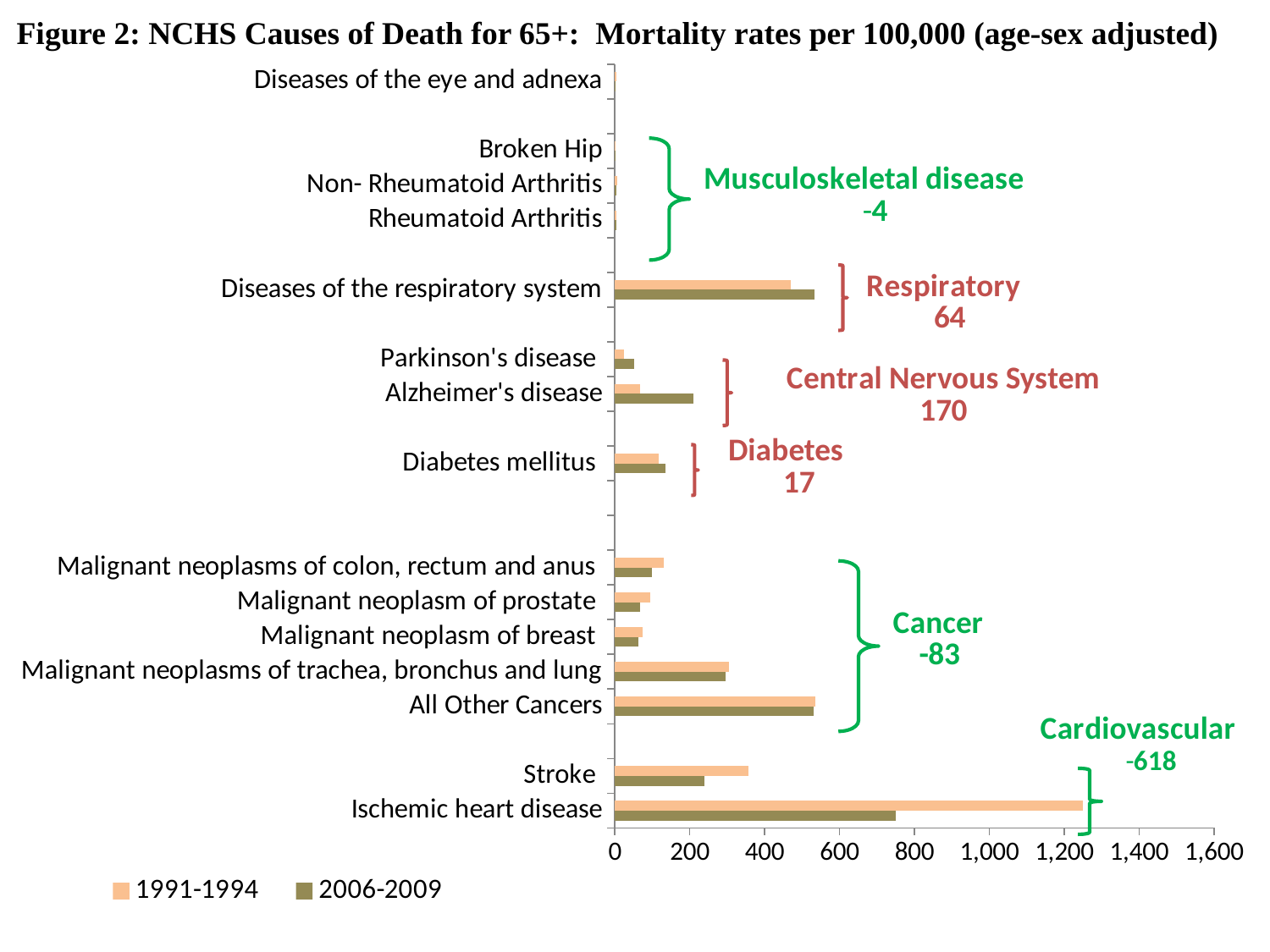
Is the 2006-2009 value for Ischemic heart disease greater or less than 800? less Which cause of death has the highest mortality rate for 2006-2009? Ischemic heart disease Is the 2006-2009 value for Diseases of the respiratory system greater or less than 400? greater For Ischemic heart disease, which period has the larger mortality rate, 1991-1994 or 2006-2009? 1991-1994 What change is annotated for the Central Nervous System group? 170 What change is annotated for the Cardiovascular group? -618 What kind of chart is shown on the slide? bar chart How many series does the legend list? 2 For Alzheimer's disease, which period has the larger mortality rate, 1991-1994 or 2006-2009? 2006-2009 Is the 1991-1994 value for Ischemic heart disease greater or less than 1,200? greater Which cause of death has the highest mortality rate for 1991-1994? Ischemic heart disease For Stroke, which period has the larger mortality rate, 1991-1994 or 2006-2009? 1991-1994